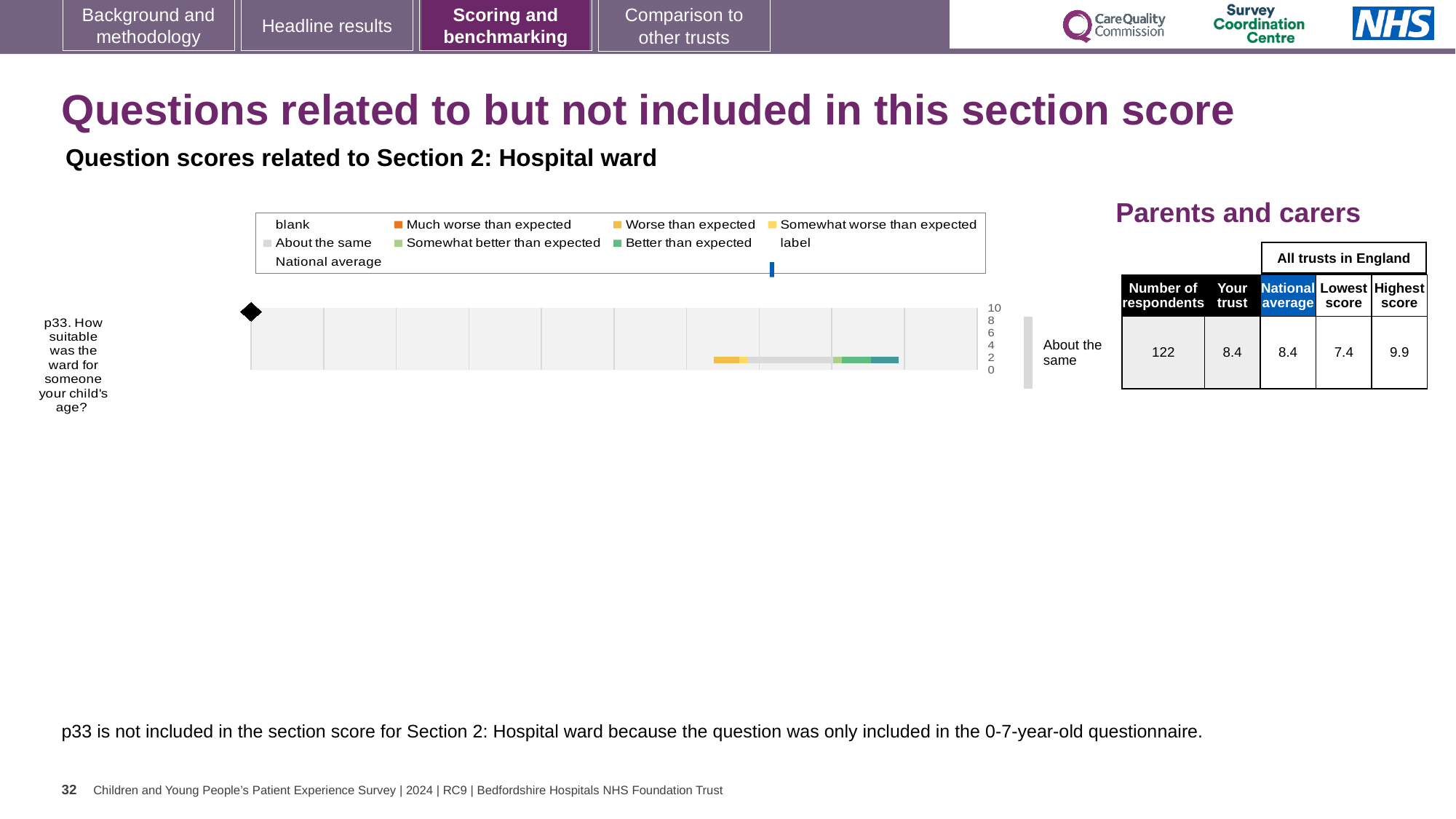
How many respondents answered p33 according to the table? 122 What kind of chart is used to show the benchmarking result for question p33? bar chart What is the difference between the highest score and the lowest score for p33 in the table? 2.5 What is the highest value shown on the chart's axis? 10 In the table, what is the highest score among all trusts in England for p33? 9.9 In the table, what is the national average score for p33? 8.4 Is the 'Your trust' score for p33 larger than, smaller than, or equal to the national average? equal Which question is plotted in the chart? p33. How suitable was the ward for someone your child's age? What benchmarking category label is shown next to the bar for p33? About the same How many questions are plotted in the chart? 1 In the table, what is the 'Your trust' score for p33? 8.4 In the table, what is the lowest score among all trusts in England for p33? 7.4